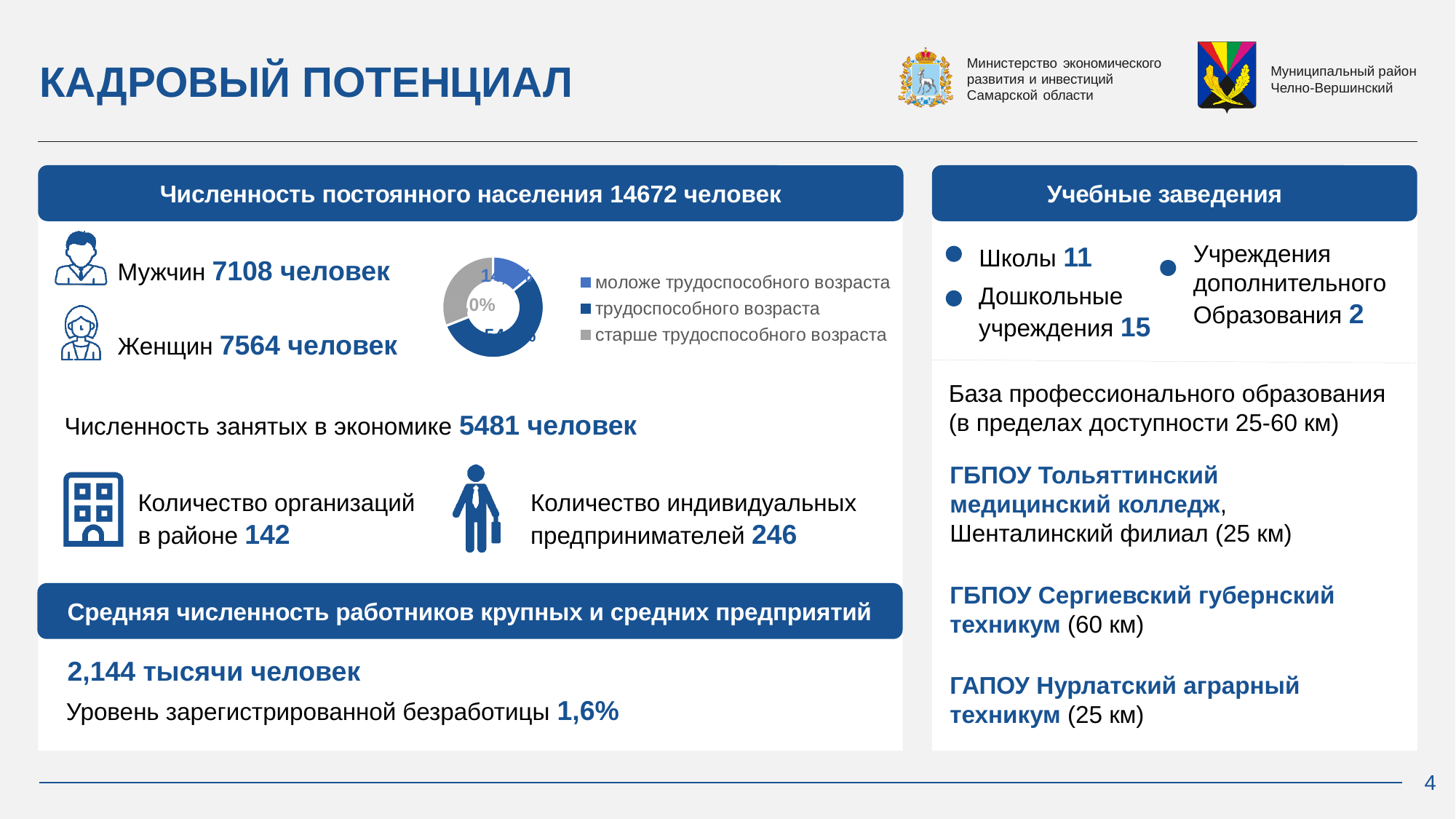
How many entries are in the legend of the donut chart? 3 Which category has the largest share in the donut chart? трудоспособного возраста How many categories does the legend of the donut chart list? 3 Which share is larger in the donut chart: моложе трудоспособного возраста or старше трудоспособного возраста? старше трудоспособного возраста Which share is larger in the donut chart: трудоспособного возраста or старше трудоспособного возраста? трудоспособного возраста What kind of chart is shown on the slide? Pie chart (donut) What colour represents the category 'трудоспособного возраста' in the donut chart? Dark blue What colour represents the category 'старше трудоспособного возраста' in the donut chart? Gray Which category has the smallest share in the donut chart? моложе трудоспособного возраста